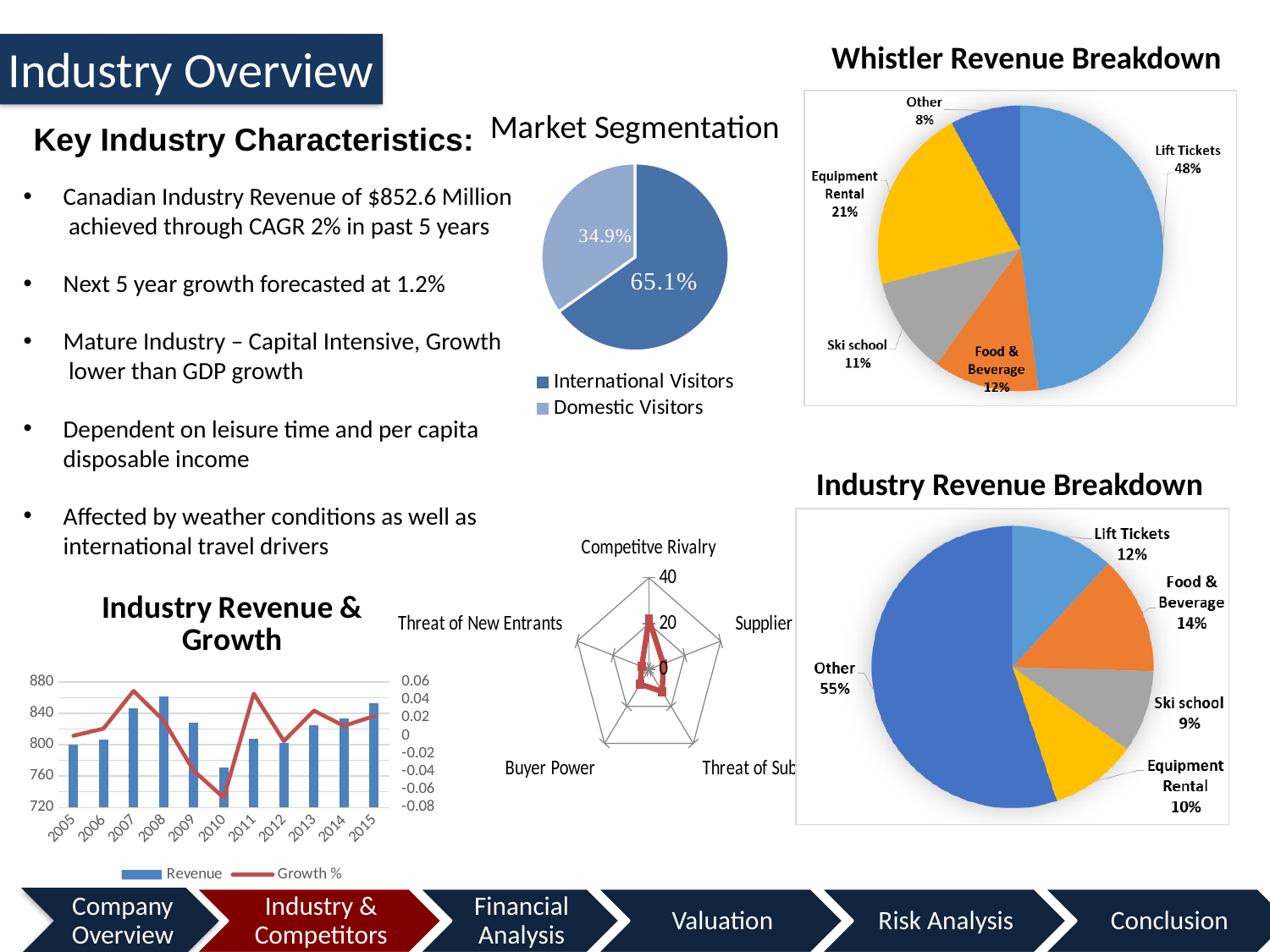
In the Whistler Revenue Breakdown chart, what is the difference between Equipment Rental and Food & Beverage? 9% In the Market Segmentation pie chart, what share is International Visitors? 65.1% In the Industry Revenue Breakdown chart, which is larger, Food & Beverage or Lift Tickets? Food & Beverage How many categories are shown in the Whistler Revenue Breakdown pie chart? 5 In the Industry Revenue Breakdown chart, what percentage is Other? 55% What kind of chart is the one with Competitve Rivalry, Supplier and Buyer Power axes? radar chart In the Whistler Revenue Breakdown chart, what percentage is Lift Tickets? 48% In the Market Segmentation chart, how many entries does the legend list? 2 In the Market Segmentation pie chart, what share is Domestic Visitors? 34.9% In the Whistler Revenue Breakdown chart, which category has the smallest share? Other In the Industry Revenue & Growth chart, is the Revenue value for 2010 greater or less than 800? less In the Industry Revenue & Growth chart, which year has the lowest Revenue bar? 2010